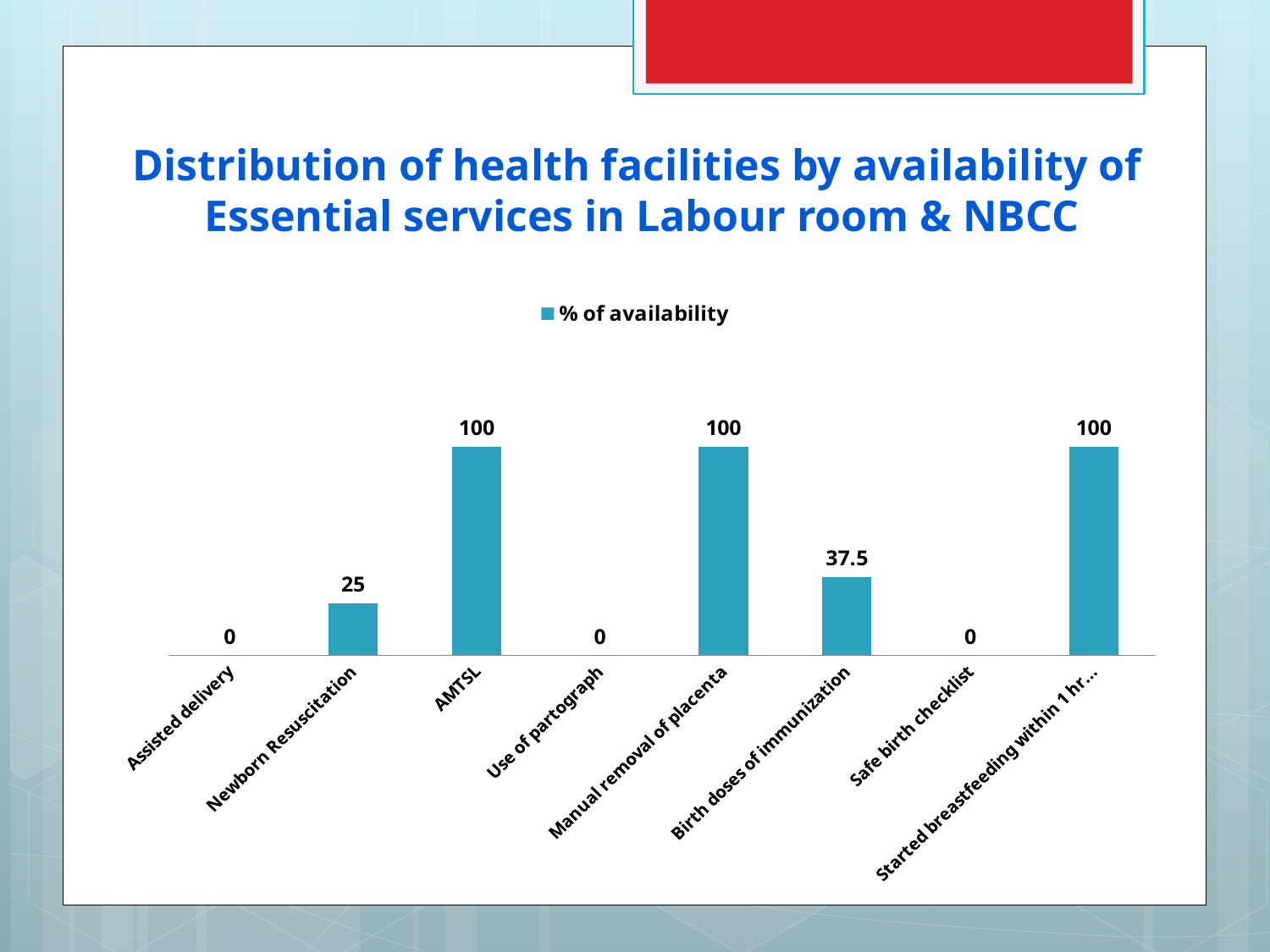
What is the % of availability for AMTSL? 100 What is the % of availability for Use of partograph? 0 How many categories are shown on the x axis of the chart? 8 Which has a higher % of availability, AMTSL or Safe birth checklist? AMTSL What is the difference between the % of availability for Manual removal of placenta and Birth doses of immunization? 62.5 What type of chart is shown on the slide? Bar chart Which has a higher % of availability, Newborn Resuscitation or Birth doses of immunization? Birth doses of immunization What is the % of availability for Safe birth checklist? 0 What is the difference between the % of availability for Birth doses of immunization and Newborn Resuscitation? 12.5 What is the % of availability for Birth doses of immunization? 37.5 What is the % of availability for Newborn Resuscitation? 25 How many series does the chart legend list? 1